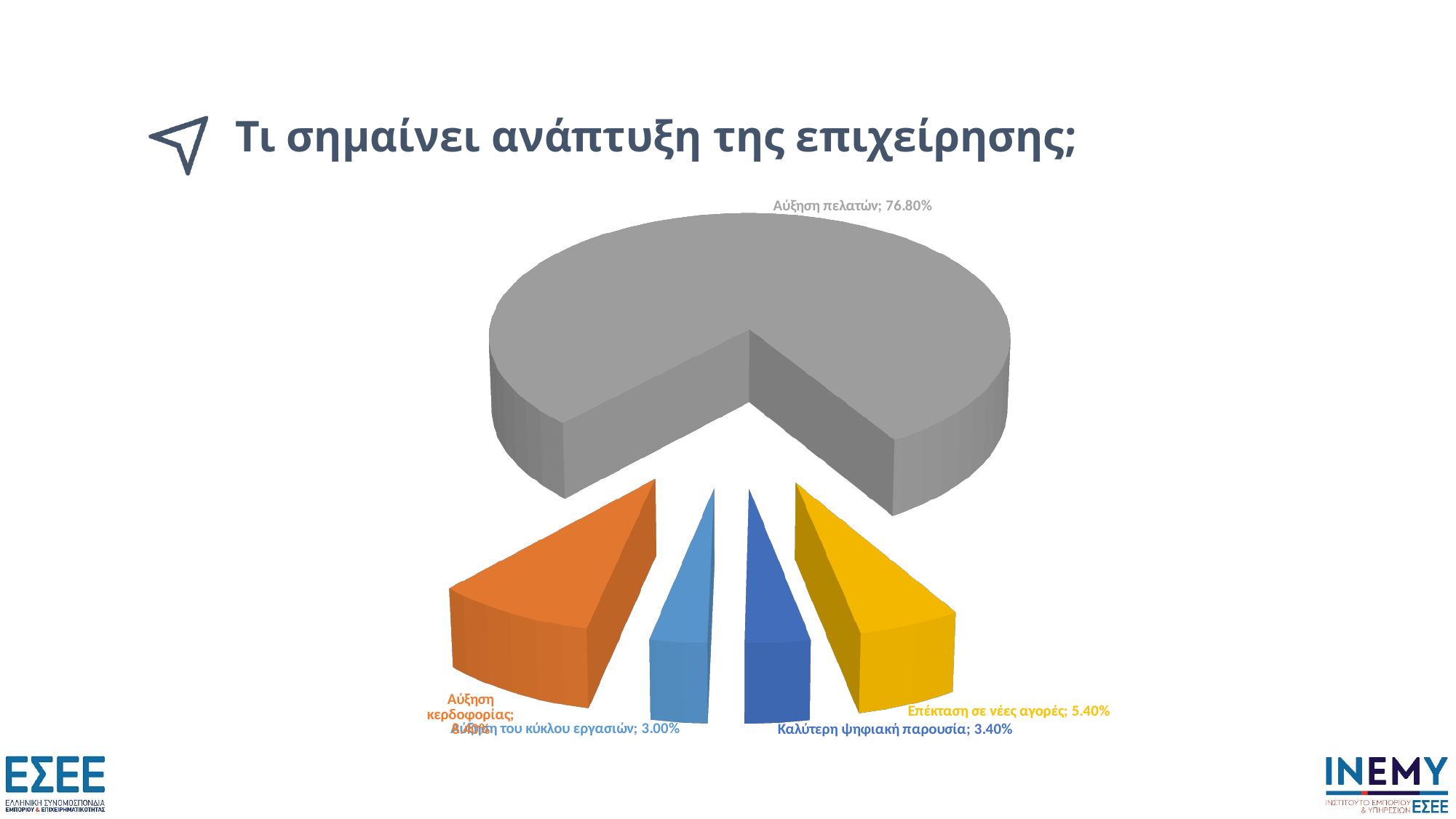
Which is larger: Επέκταση σε νέες αγορές or Καλύτερη ψηφιακή παρουσία? Επέκταση σε νέες αγορές What is the title of the slide? Τι σημαίνει ανάπτυξη της επιχείρησης; How many slices does the pie chart have? 5 What percentage is shown for Αύξηση πελατών? 76.80% What percentage is shown for Επέκταση σε νέες αγορές? 5.40% What is the difference between the shares of Αύξηση πελατών and Επέκταση σε νέες αγορές? 71.40% What kind of chart is shown on the slide? pie chart What percentage is shown for Αύξηση του κύκλου εργασιών? 3.00% Which category has the smallest share of the pie? Αύξηση του κύκλου εργασιών What colour is the slice for Αύξηση πελατών? grey What percentage is shown for Καλύτερη ψηφιακή παρουσία? 3.40% Which category has the largest share of the pie? Αύξηση πελατών